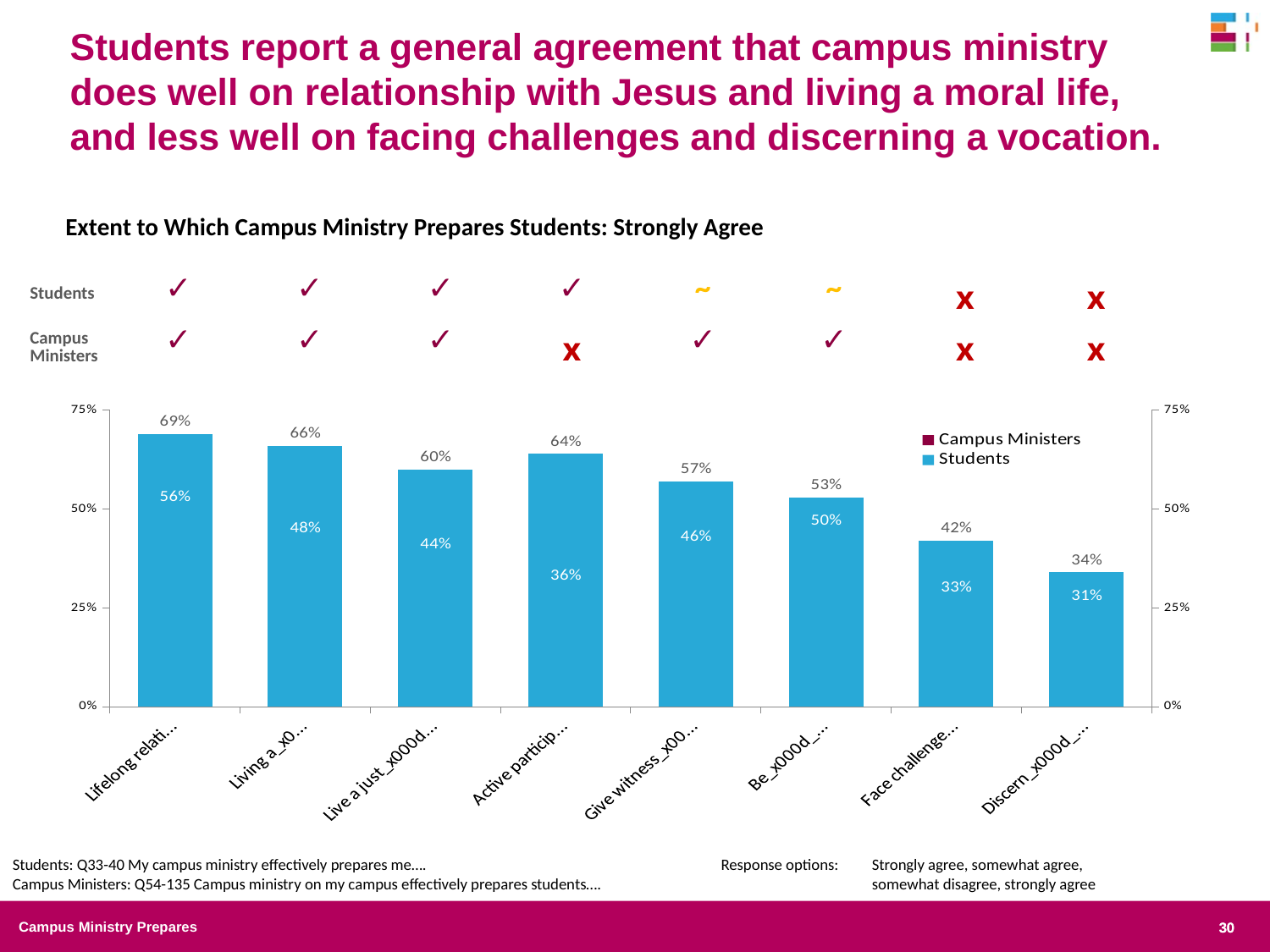
What is the chart's title? Extent to Which Campus Ministry Prepares Students: Strongly Agree Which bar is the tallest in the chart? The leftmost bar (Lifelong relati...) What value is printed inside the rightmost bar (Discern...)? 31% What kind of chart is shown on the slide? Bar chart Is the value printed above the rightmost bar greater or less than 50%? less How many series does the chart legend list? 2 For the leftmost bar, what is the difference between the value printed above it (69%) and the value printed inside it (56%)? 13 percentage points What are the two entries in the chart legend? Campus Ministers and Students Which bar is the shortest in the chart? The rightmost bar (Discern...) What value is printed above the bar for Face challenge...? 42% How many bars (categories) are plotted in the chart? 8 What value is printed above the leftmost bar (Lifelong relati...)? 69%